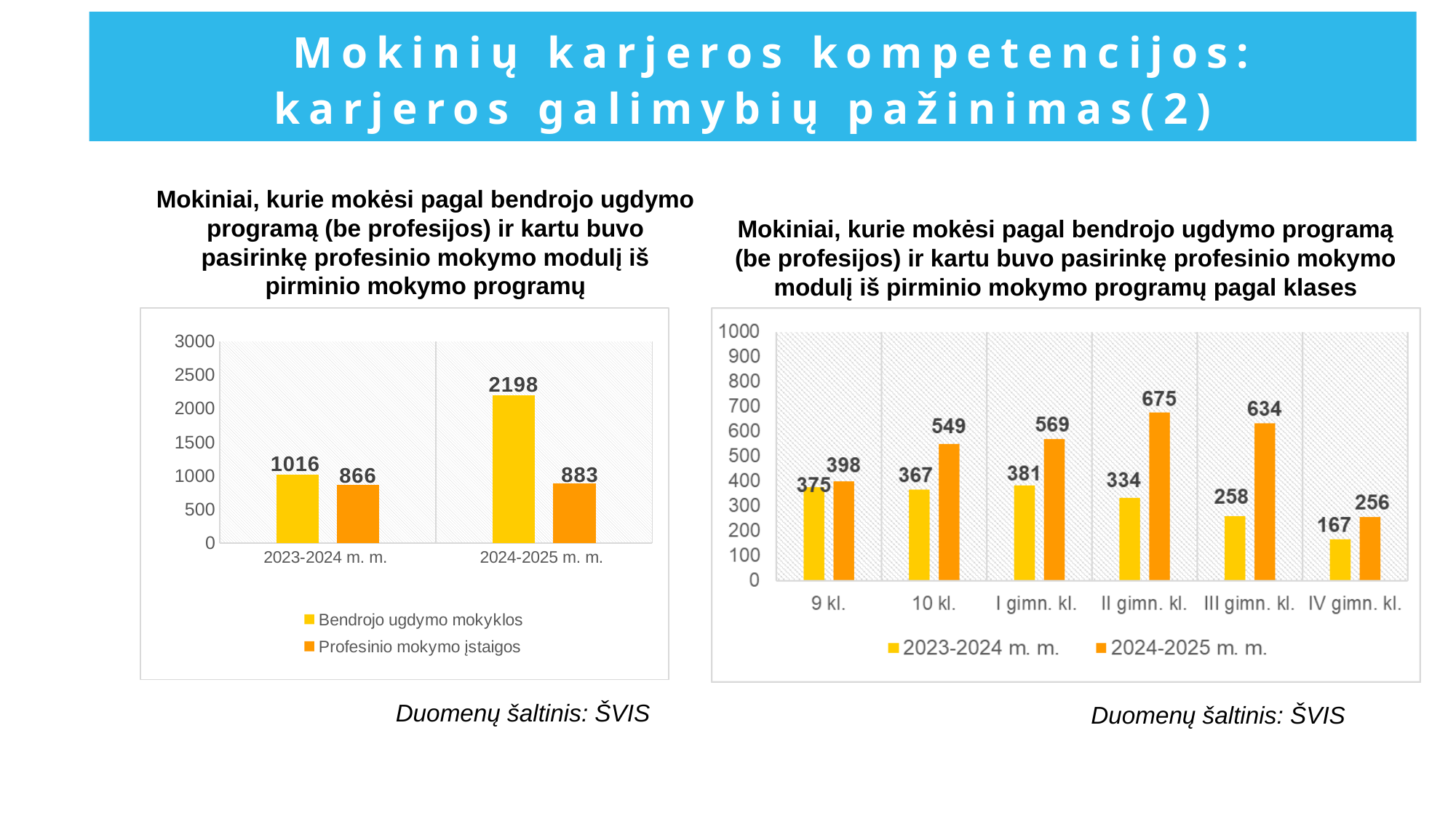
In the right chart, how many class categories are shown on the x axis? 6 In the right chart, is the 2023-2024 m. m. value for 10 kl. larger or smaller than the 2024-2025 m. m. value for 10 kl.? Smaller In the left chart, how many series does the legend list? 2 What kind of chart is the left chart? Bar chart In the right chart, which class has the lowest value for 2023-2024 m. m.? IV gimn. kl. In the right chart, what is the value for II gimn. kl. in 2024-2025 m. m.? 675 In the left chart, what is the value for Profesinio mokymo įstaigos in 2023-2024 m. m.? 866 In the left chart, what is the value for Bendrojo ugdymo mokyklos in 2024-2025 m. m.? 2198 In the right chart, which class has the highest value for 2024-2025 m. m.? II gimn. kl. In the right chart, what is the difference between the 2024-2025 m. m. and 2023-2024 m. m. values for III gimn. kl.? 376 In the right chart, what is the value for IV gimn. kl. in 2023-2024 m. m.? 167 In the left chart, what is the difference between Bendrojo ugdymo mokyklos and Profesinio mokymo įstaigos in 2024-2025 m. m.? 1315